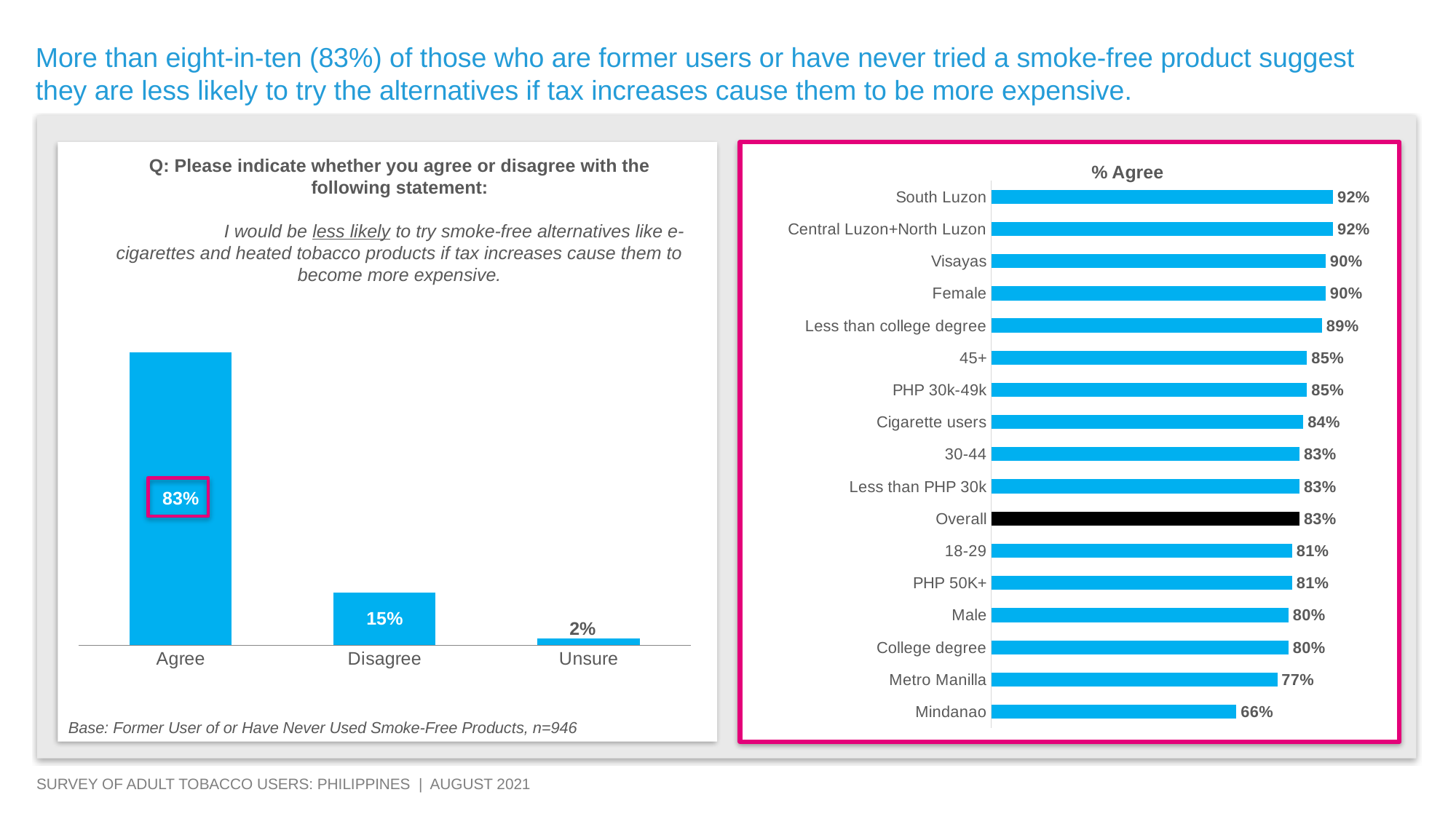
In the right chart (% Agree), which category has the lowest value? Mindanao In the right chart (% Agree), which is larger, Female or Male? Female In the right chart (% Agree), what is the value for Overall? 83% In the right chart (% Agree), what is the difference between Visayas and Mindanao? 24 percentage points In the left chart, how many categories are shown on the x axis? 3 In the left chart, what percentage of respondents Agree with the statement? 83% In the left chart, what is the difference between the Agree and Disagree percentages? 68 percentage points What kind of chart is the left chart? Bar chart In the right chart (% Agree), what is the value for Mindanao? 66% In the right chart (% Agree), how many categories are listed? 17 In the left chart, what percentage of respondents are Unsure? 2% In the right chart (% Agree), what is the value for Metro Manilla? 77%